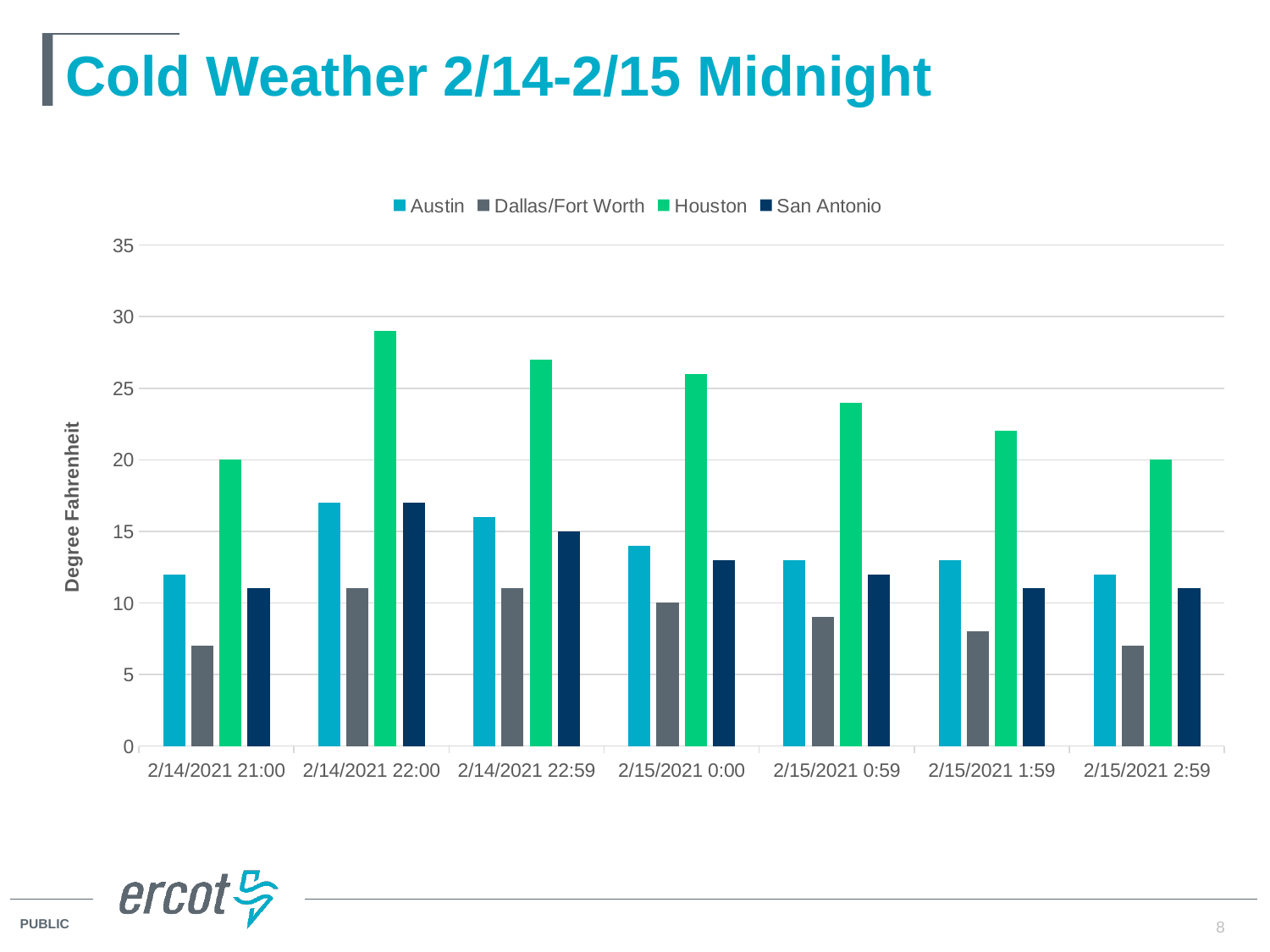
What is the value for Dallas/Fort Worth at 2/15/2021 0:00? 10 At 2/14/2021 22:00, which is larger, the value for Austin or the value for Dallas/Fort Worth? Austin How many series does the legend list? 4 Is the value for Dallas/Fort Worth at 2/15/2021 2:59 greater or less than 10? less Which city has the lowest value at 2/14/2021 21:00? Dallas/Fort Worth Which city has the highest value at 2/14/2021 22:00? Houston Do the Houston values rise or fall from 2/14/2021 22:00 to 2/15/2021 2:59? fall What is the value for Houston at 2/14/2021 21:00? 20 What kind of chart is shown on the slide? bar chart What is the value for San Antonio at 2/14/2021 22:59? 15 How many time points are shown on the x axis? 7 Is the value for Houston at 2/14/2021 22:00 greater or less than 25? greater